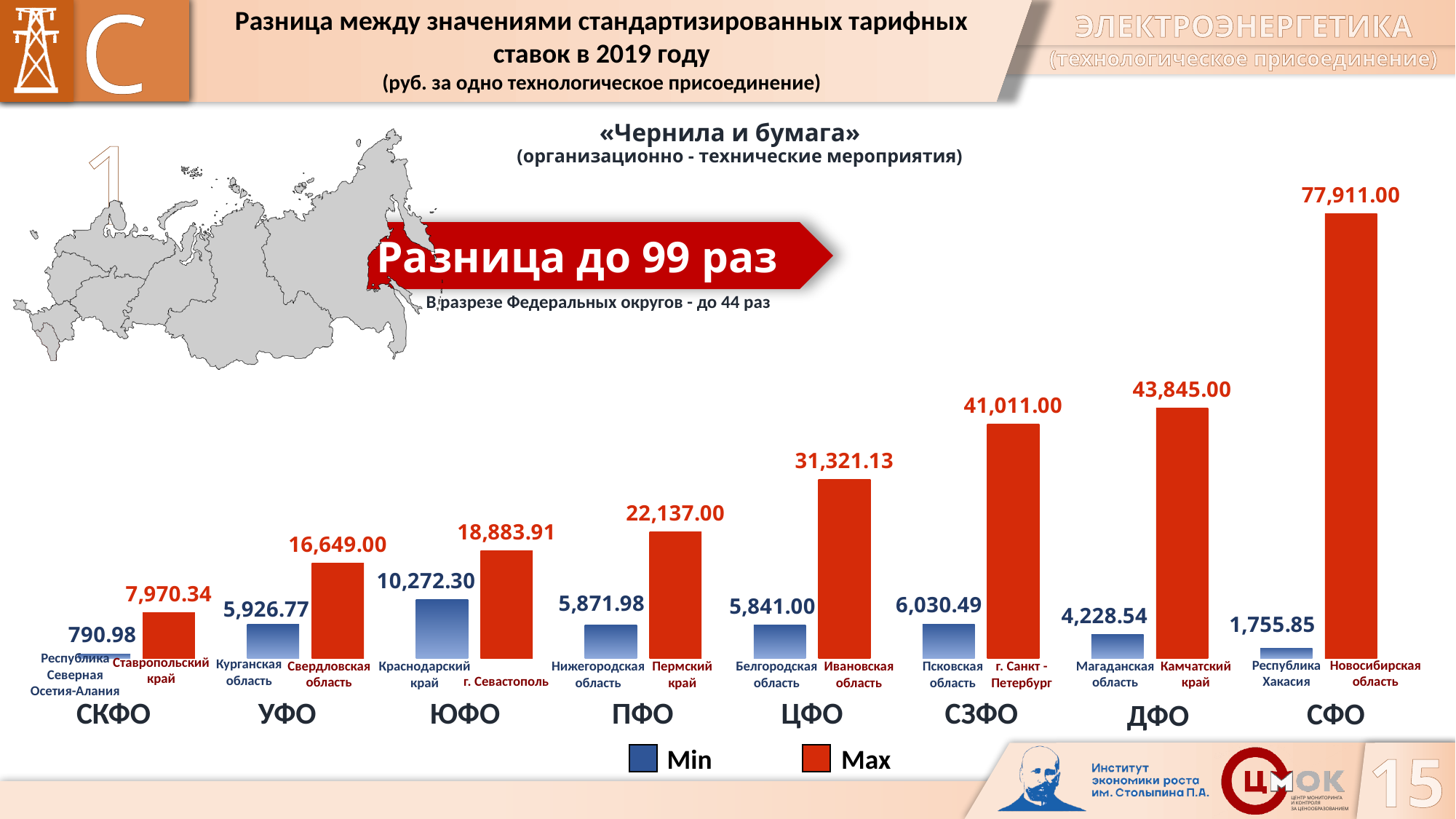
Which federal district has the highest Max value? СФО What is the Max value for ПФО? 22,137.00 What is the difference between the Max values for СФО and ДФО? 34,066.00 What is the Min value for ЮФО? 10,272.30 What is the Min value for СКФО? 790.98 Which federal district has the lowest Min value? СКФО What is the difference between the Max and Min values for СФО? 76,155.15 What is the Max value for СФО? 77,911.00 How many series does the legend list? 2 What kind of chart is shown on the slide? Bar chart How many federal districts are shown on the x axis? 8 Which is larger, the Max value for СЗФО or the Max value for ЦФО? СЗФО